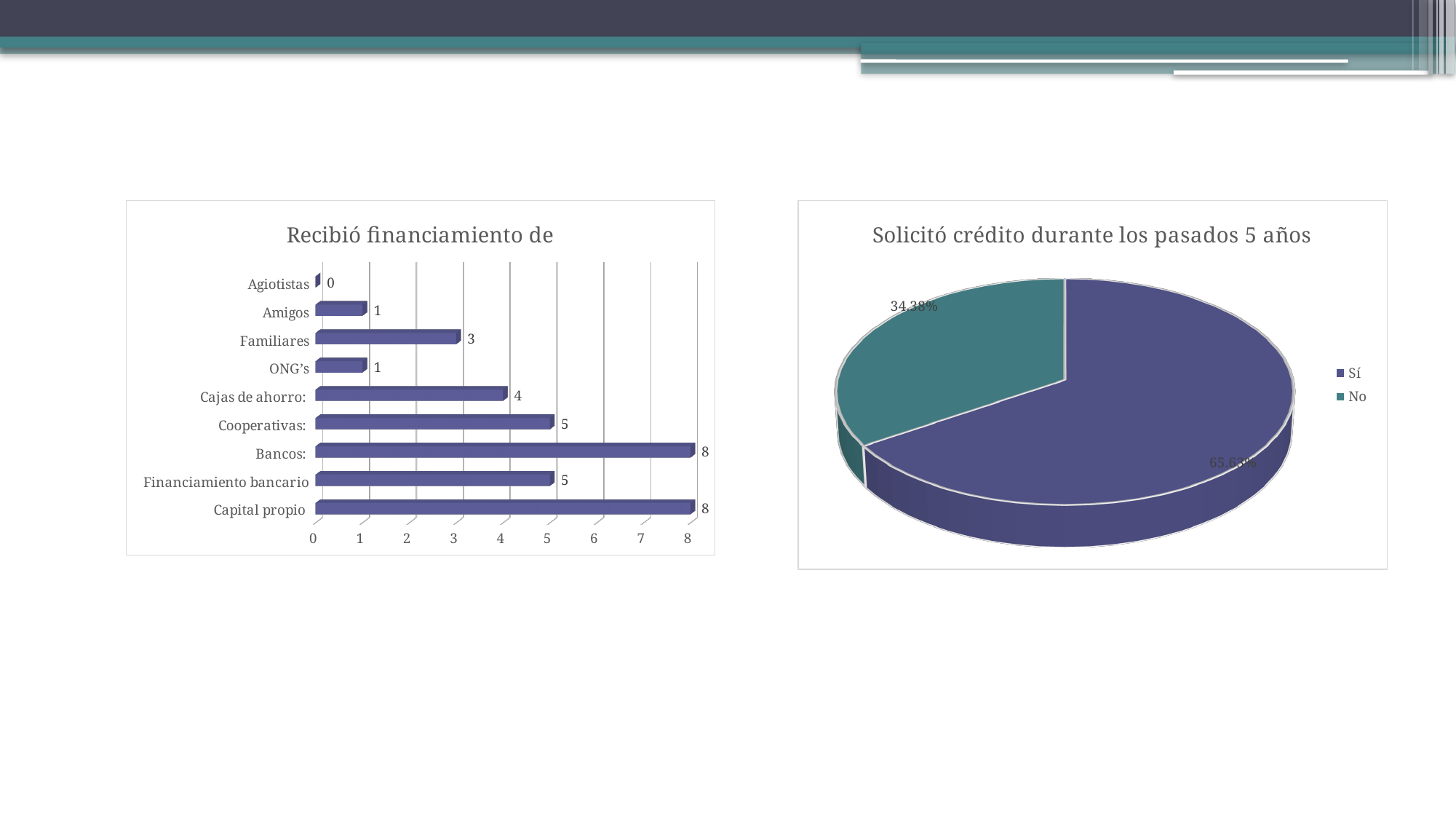
How many categories are shown in the chart 'Recibió financiamiento de'? 9 In the chart 'Recibió financiamiento de', what is the value for Agiotistas? 0 In the chart 'Solicitó crédito durante los pasados 5 años', what share does the 'No' slice have? 34.38% In the chart 'Solicitó crédito durante los pasados 5 años', which slice is larger, 'Sí' or 'No'? Sí What kind of chart is 'Solicitó crédito durante los pasados 5 años'? Pie chart What kind of chart is 'Recibió financiamiento de'? Bar chart In the chart 'Recibió financiamiento de', what is the value for Cajas de ahorro? 4 In the chart 'Recibió financiamiento de', what is the difference between the values for Bancos and Cooperativas? 3 How many entries does the legend of the chart 'Solicitó crédito durante los pasados 5 años' list? 2 In the chart 'Recibió financiamiento de', what is the value for Familiares? 3 In the chart 'Recibió financiamiento de', which category has the lowest value? Agiotistas In the chart 'Recibió financiamiento de', which is larger, the value for Familiares or the value for Amigos? Familiares